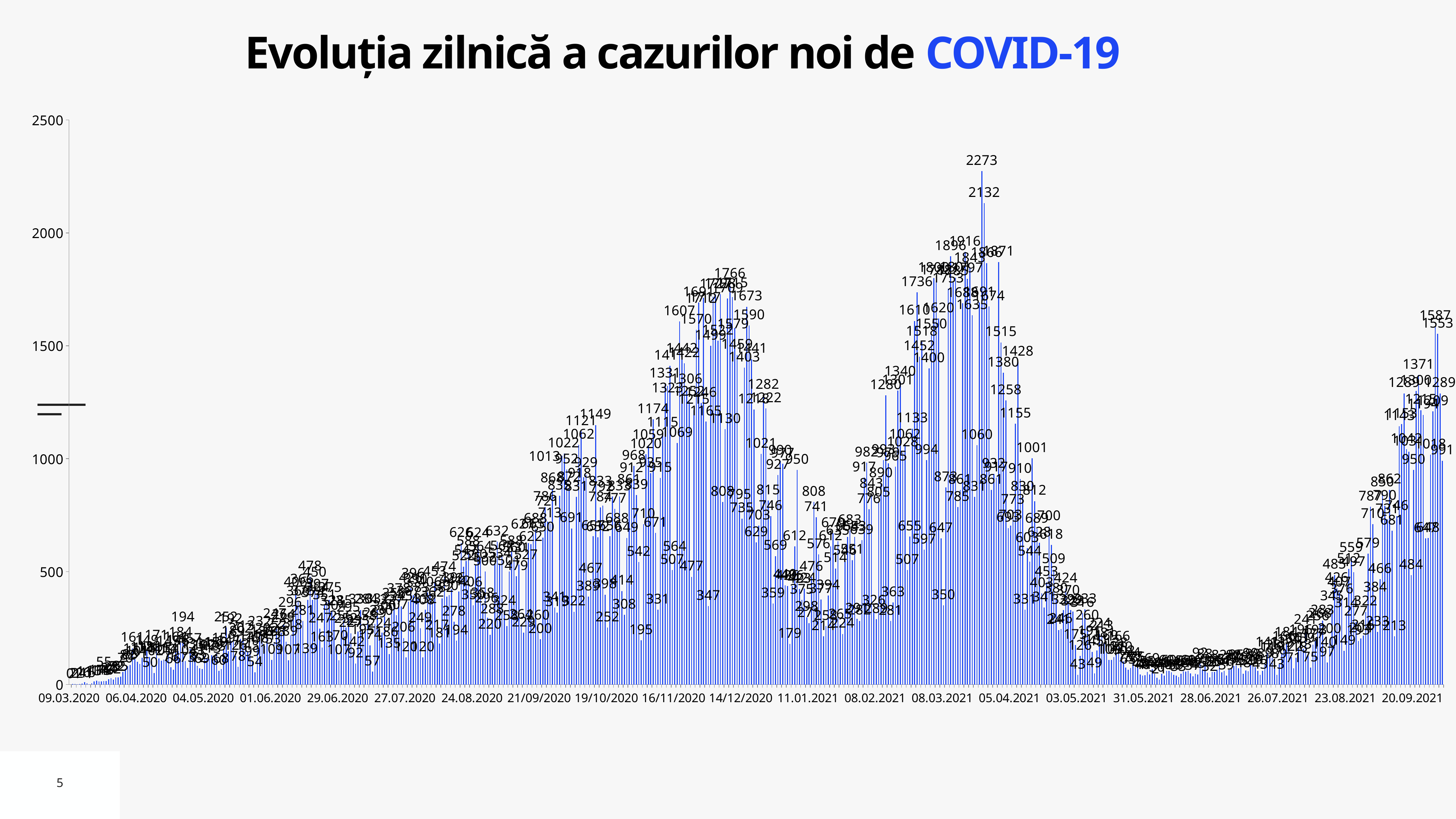
What is the title of the chart? Evoluția zilnică a cazurilor noi de COVID-19 What is the highest daily value labelled on the chart? 2273 Do the daily values rise or fall between 05.04.2021 and 31.05.2021? fall Do the daily values rise or fall between 26.07.2021 and 20.09.2021? rise What is the difference between the two highest labelled values, 2273 and 2132? 141 Is the highest peak of the chart located near 05.04.2021 or near 14.12.2020? near 05.04.2021 What is the second-highest daily value labelled on the chart, just below the 2273 peak? 2132 What kind of chart is shown on the slide? bar chart Are the values for the first days of the chart, around 09.03.2020, greater or less than 500? less Is the highest peak of the chart greater or less than 2000? greater What is the highest value labelled on the y axis? 2500